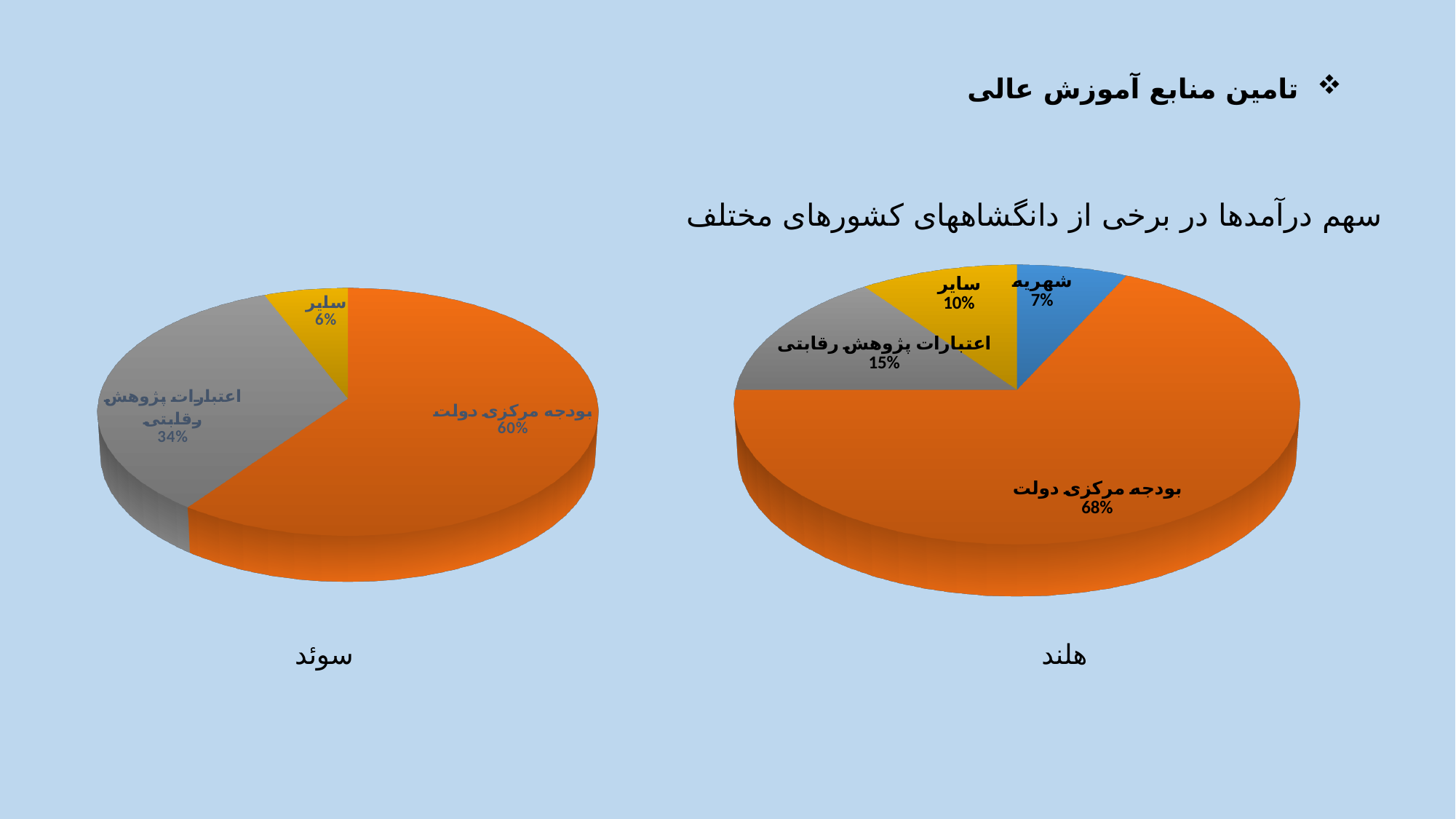
In the pie chart labelled هلند (right), which category has the smallest share? شهریه How many slices does the pie chart labelled سوئد (left) have? 3 In the pie chart labelled هلند (right), what share is اعتبارات پژوهش رقابتی? 15% In the pie chart labelled هلند (right), what share is بودجه مرکزی دولت? 68% How many slices does the pie chart labelled هلند (right) have? 4 In the pie chart labelled سوئد (left), what share is سایر? 6% Which chart shows a larger share for سایر, the one labelled هلند or the one labelled سوئد? هلند What type of chart is used for the chart labelled هلند (right)? Pie chart In the pie chart labelled هلند (right), what share is شهریه? 7% In the pie chart labelled هلند (right), what is the difference between the shares of بودجه مرکزی دولت and اعتبارات پژوهش رقابتی? 53% In the pie chart labelled سوئد (left), what share is اعتبارات پژوهش رقابتی? 34% In the pie chart labelled سوئد (left), which category has the largest share? بودجه مرکزی دولت